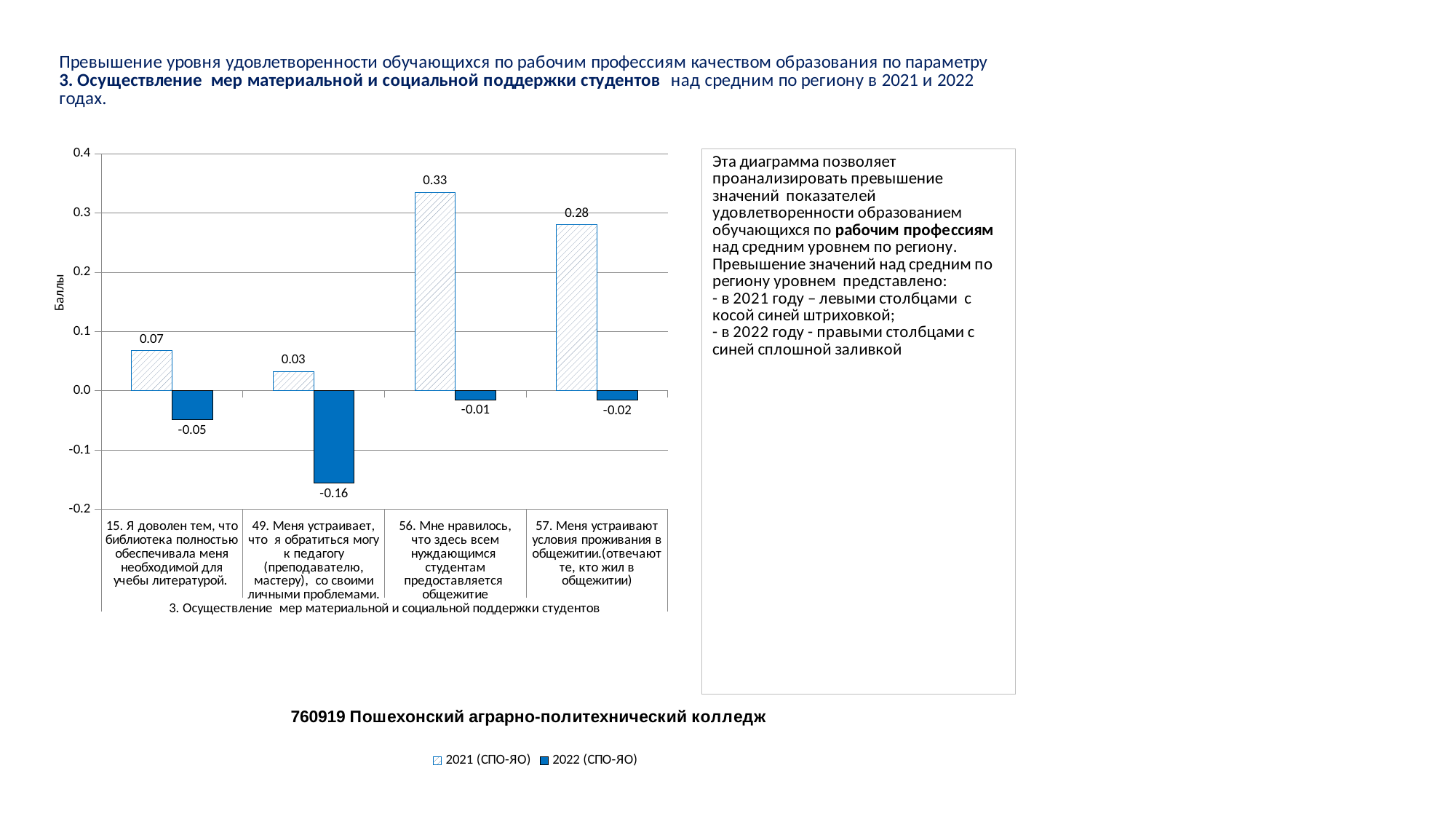
Which category has the highest 2021 (СПО-ЯО) value? 56. Мне нравилось, что здесь всем нуждающимся студентам предоставляется общежитие How many categories (questions) are shown on the x axis? 4 What is the 2022 (СПО-ЯО) value for category 49 (Меня устраивает, что я обратиться могу к педагогу)? -0.16 How many series does the legend list? 2 What is the difference between the 2021 (СПО-ЯО) values for category 56 and category 57? 0.05 What is the 2022 (СПО-ЯО) value for category 57 (Меня устраивают условия проживания в общежитии)? -0.02 What is the 2021 (СПО-ЯО) value for category 15 (Я доволен тем, что библиотека полностью обеспечивала меня необходимой для учебы литературой)? 0.07 Which is larger: the 2021 (СПО-ЯО) value for category 15 or for category 49? category 15 Which category has the lowest 2022 (СПО-ЯО) value? 49. Меня устраивает, что я обратиться могу к педагогу (преподавателю, мастеру), со своими личными проблемами. What is the label of the y axis? Баллы What type of chart is shown on the slide? bar chart What is the 2021 (СПО-ЯО) value for category 56 (Мне нравилось, что здесь всем нуждающимся студентам предоставляется общежитие)? 0.33